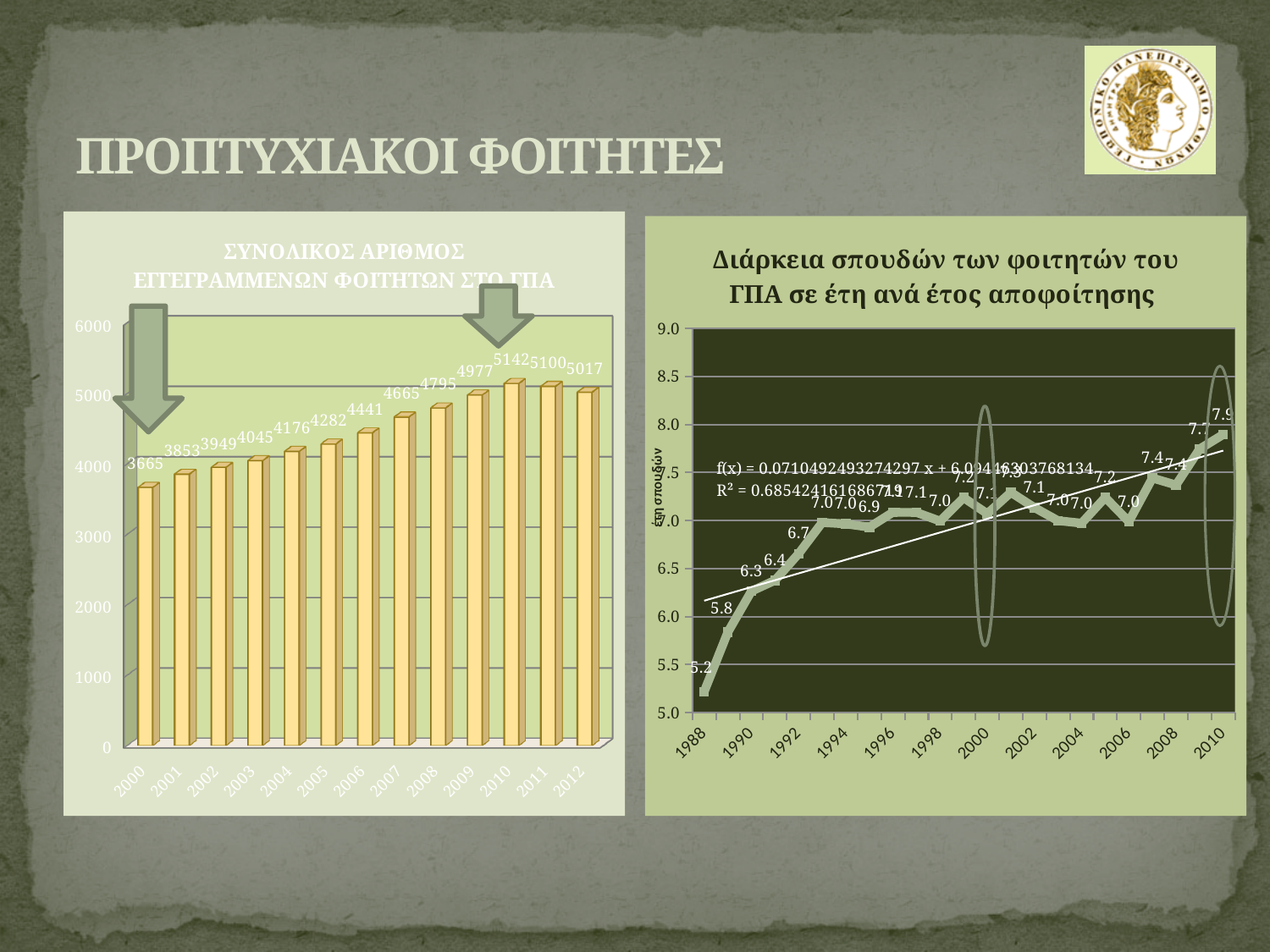
In the left chart, which year has the highest number of registered students? 2010 How many years are shown on the x axis of the left chart? 13 In the right chart, which year has the highest study duration? 2010 In the left chart, what is the difference between the values for 2010 and 2000? 1477 In the left chart, which year has the larger value, 2011 or 2012? 2011 In the left chart, which year has the lowest number of registered students? 2000 In the right chart, do the values generally rise or fall from 1988 to 2010? rise What kind of chart is the left chart? bar chart In the right chart (Διάρκεια σπουδών των φοιτητών του ΓΠΑ), what is the value for 1988? 5.2 In the right chart, what is the difference between the values for 2010 and 1988? 2.7 In the right chart, what is the value for 2010? 7.9 In the left chart (ΣΥΝΟΛΙΚΟΣ ΑΡΙΘΜΟΣ ΕΓΓΕΓΡΑΜΜΕΝΩΝ ΦΟΙΤΗΤΩΝ ΣΤΟ ΓΠΑ), what is the value for 2000? 3665